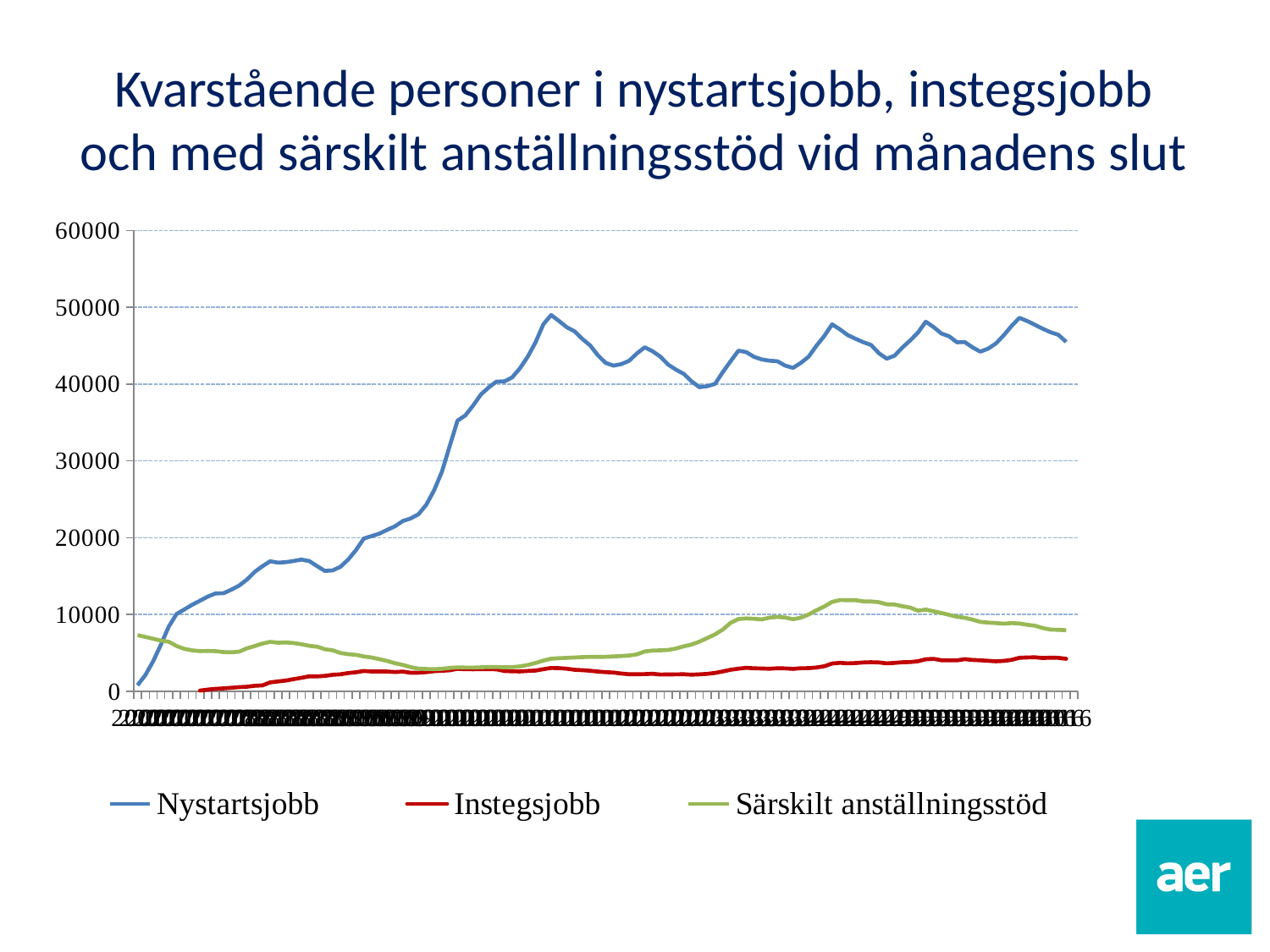
Is the peak value of the Nystartsjobb line greater or less than 50000? less How many series does the legend list? 3 Is the peak value of the Nystartsjobb line greater or less than 40000? greater Which series is plotted with the red line? Instegsjobb Is the highest value of the Instegsjobb line greater or less than 10000? less Which series reaches the highest values on the chart? Nystartsjobb Does the Nystartsjobb line overall rise or fall from the left of the chart to the right? rise At the right end of the chart, which is larger: Nystartsjobb or Särskilt anställningsstöd? Nystartsjobb Which series stays lowest across most of the chart? Instegsjobb Which series is plotted with the blue line? Nystartsjobb What kind of chart is shown on the slide? line chart